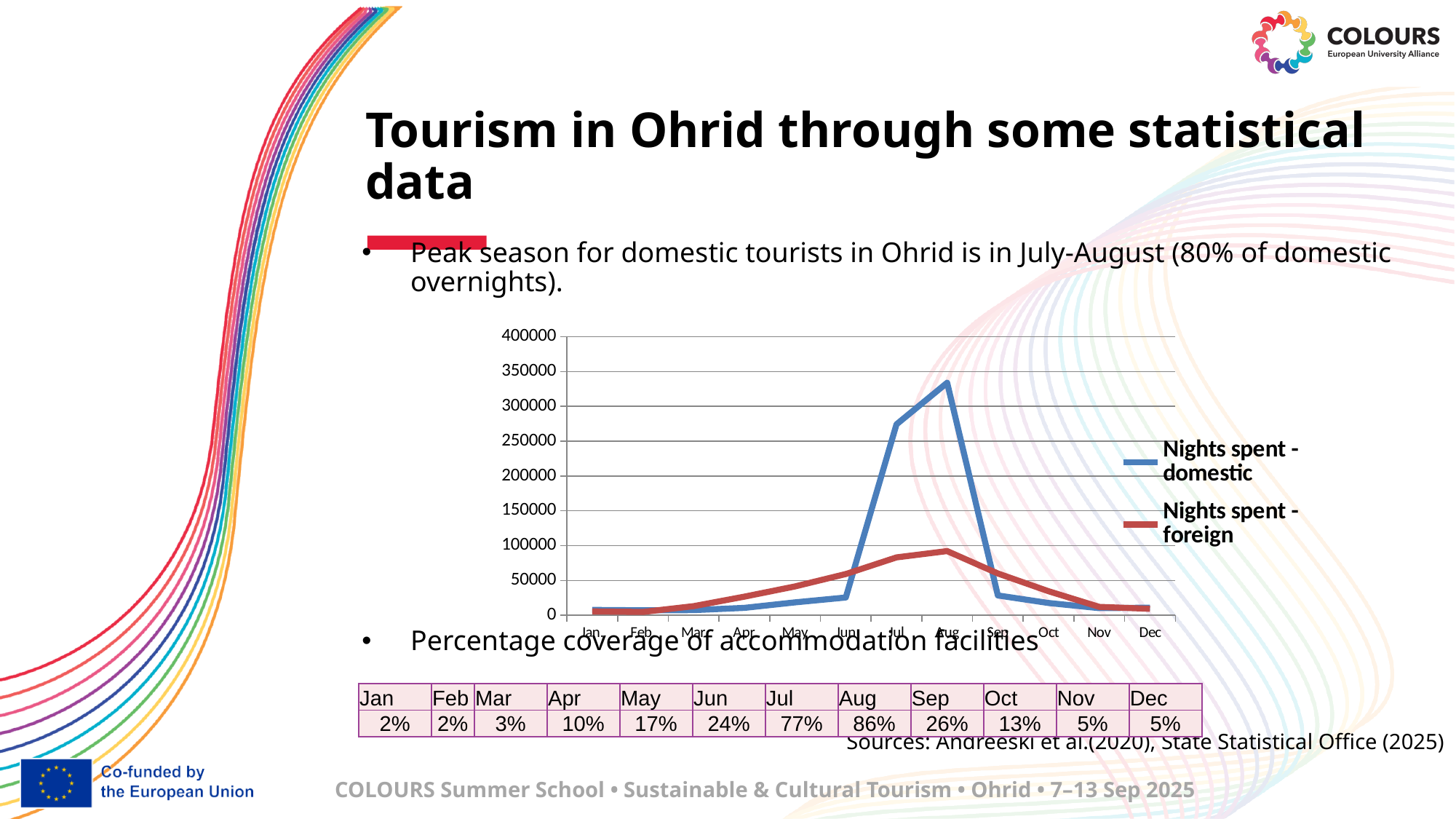
How many months are plotted along the x axis of the chart? 12 How many series does the chart's legend list? 2 In May, which series has the larger value: 'Nights spent - domestic' or 'Nights spent - foreign'? Nights spent - foreign Is the value for 'Nights spent - foreign' in Aug greater or less than 100000? less Is the value for 'Nights spent - domestic' in Sep greater or less than 50000? less In which month does the 'Nights spent - domestic' series reach its highest value? Aug Is the value for 'Nights spent - domestic' in Jul greater or less than 250000? greater In which month does the 'Nights spent - foreign' series reach its highest value? Aug Does the 'Nights spent - domestic' series rise or fall from Aug to Sep? fall What kind of chart is shown on the slide? line chart In Jul, which series has the larger value: 'Nights spent - domestic' or 'Nights spent - foreign'? Nights spent - domestic